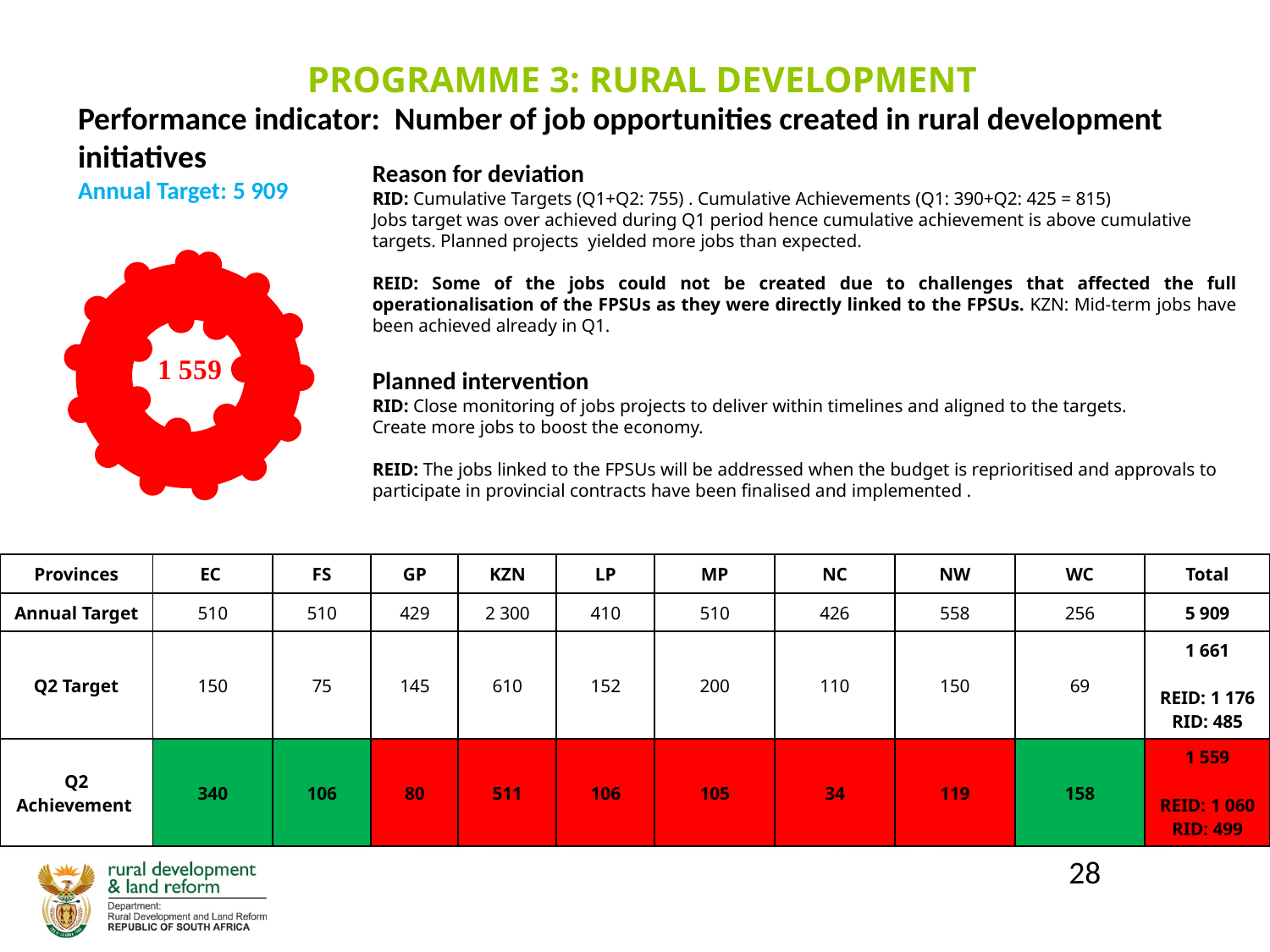
Is the value printed in the centre of the doughnut chart greater or less than 1 000? greater What kind of chart is shown on the left of the slide? Doughnut chart What colour is the ring of the doughnut chart? Red What value is printed in the centre of the doughnut chart? 1 559